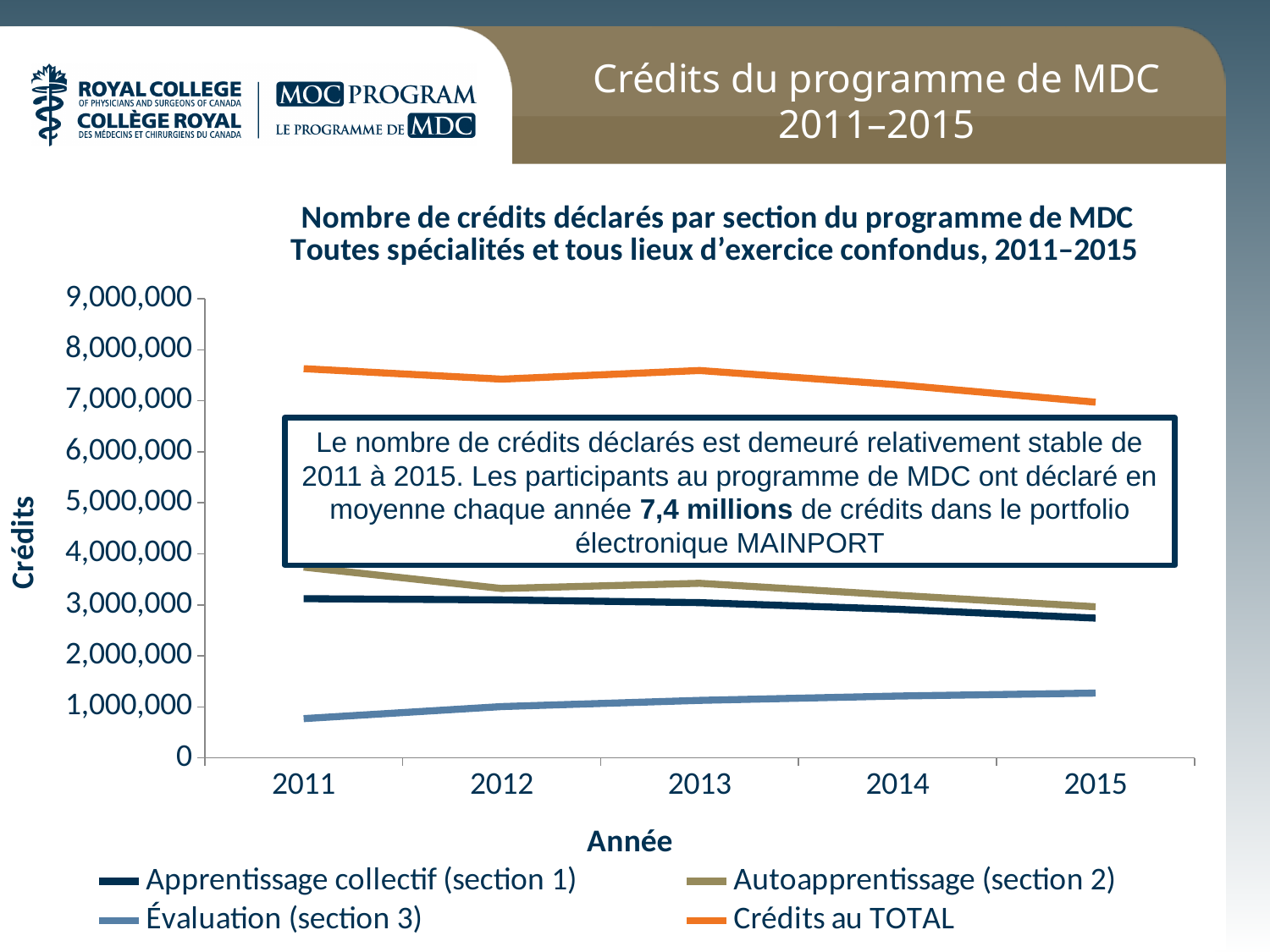
Is the value for Crédits au TOTAL in 2011 greater or less than 7,000,000? greater What kind of chart is shown on the slide? Line chart How many years are plotted along the x axis? 5 What is the label of the x axis? Année Does the Évaluation (section 3) line rise or fall from 2011 to 2015? Rise How many series does the legend list? 4 Which series has the highest values across all years? Crédits au TOTAL In 2011, which is larger: Autoapprentissage (section 2) or Apprentissage collectif (section 1)? Autoapprentissage (section 2) Which series has the lowest values across all years? Évaluation (section 3) Is the value for Évaluation (section 3) in 2015 greater or less than 1,000,000? greater Is the value for Autoapprentissage (section 2) in 2011 greater or less than 4,000,000? less